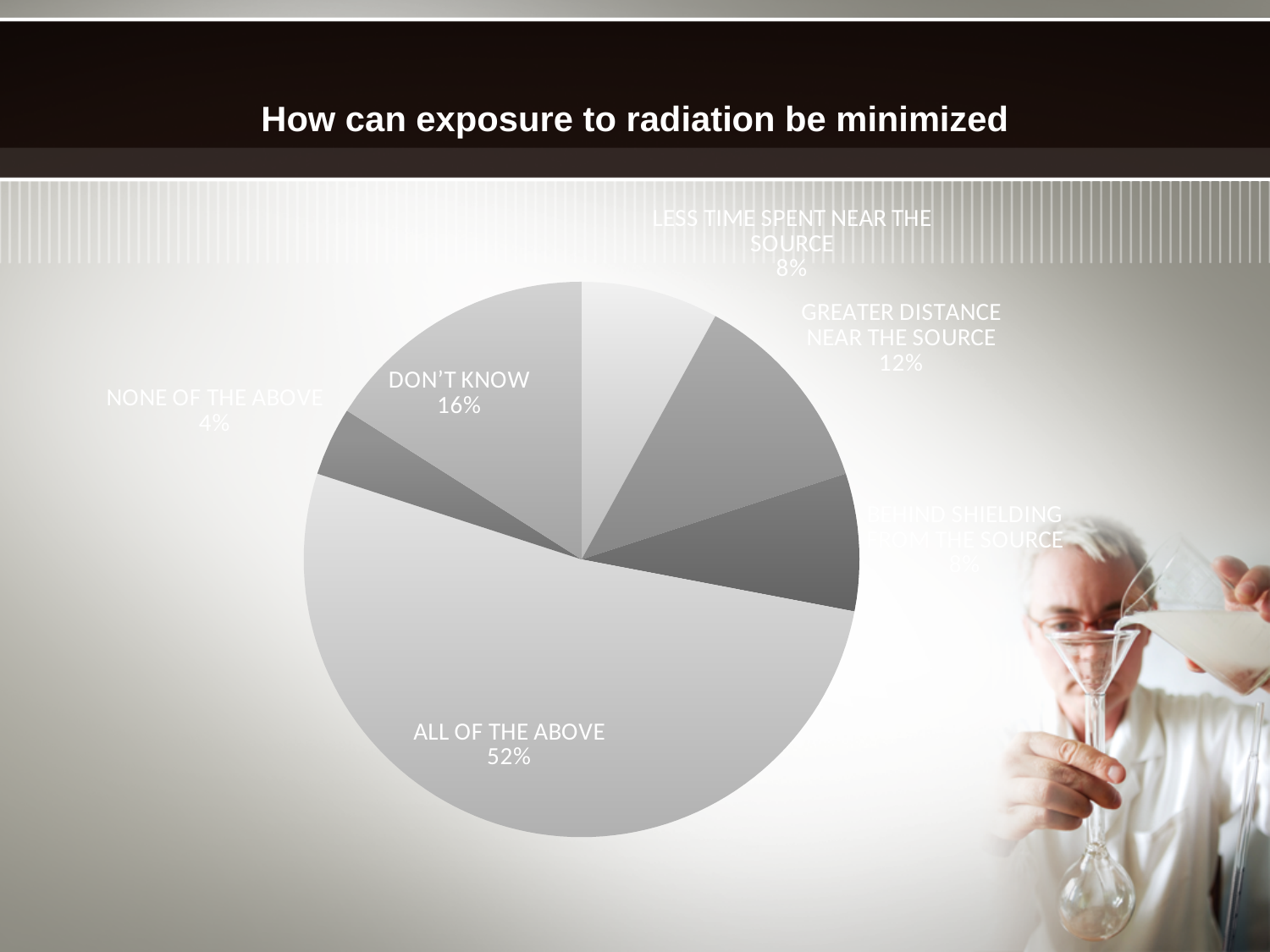
Which slice of the pie is the smallest? None of the above What share of the pie is "All of the above"? 52% What is the title of the slide containing the pie chart? How can exposure to radiation be minimized What share of the pie is "Greater distance near the source"? 12% What share of the pie is "Don't know"? 16% How many slices does the pie chart have? 6 What share of the pie is "None of the above"? 4% What is the difference between the shares for "All of the above" and "Don't know"? 36% What kind of chart is shown on the slide? pie chart Which is larger, the share for "Greater distance near the source" or the share for "Behind shielding from the source"? Greater distance near the source Which slice of the pie is the largest? All of the above What share of the pie is "Less time spent near the source"? 8%